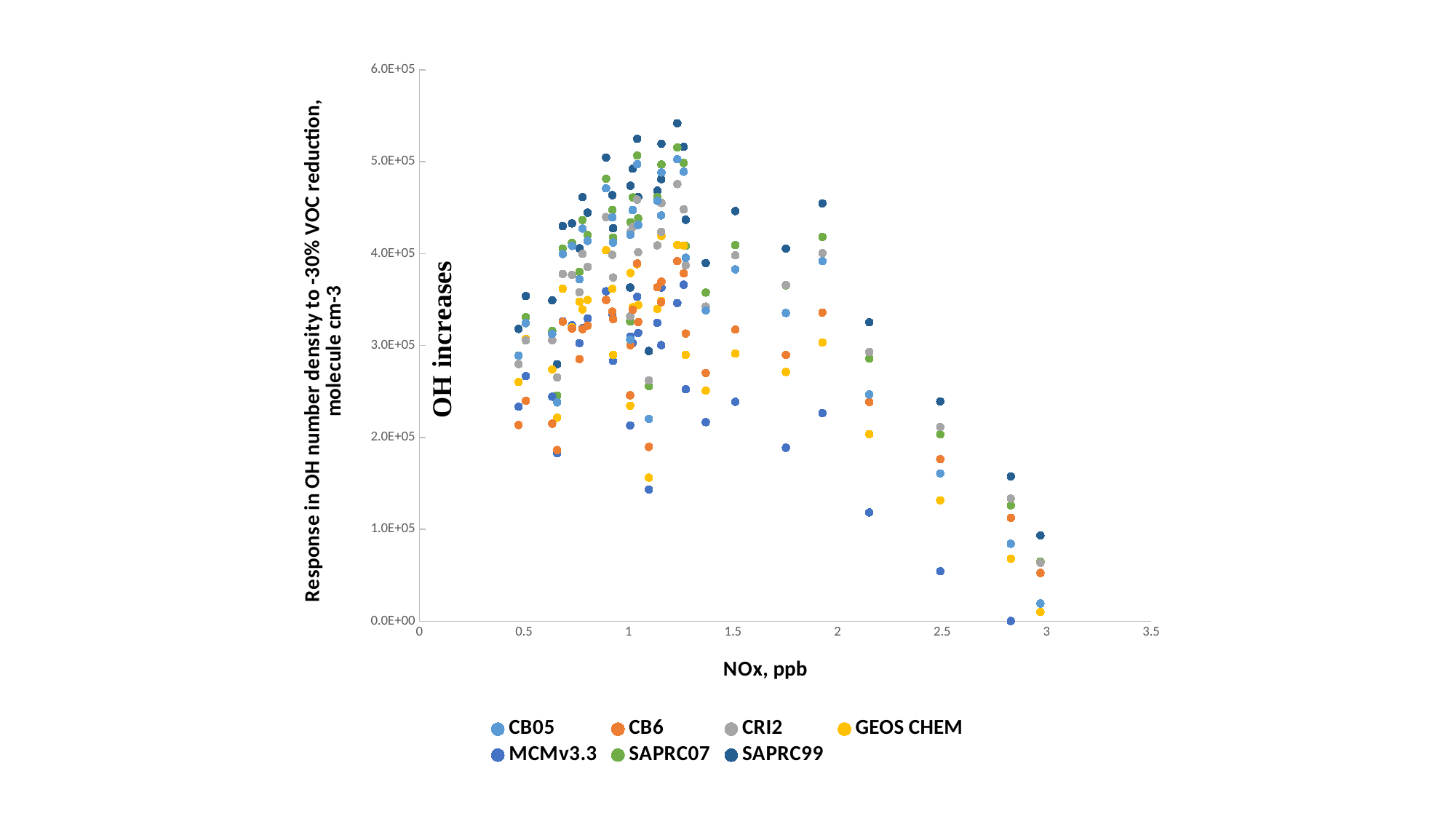
What kind of chart is shown on the slide? Scatter chart Which series has the lowest value near NOx 2.85 ppb? MCMv3.3 What is the title of the x axis? NOx, ppb Is the MCMv3.3 point near NOx 2.5 ppb greater or less than 1.0E+05? less How many series does the legend list? 7 Which series has the highest value near NOx 3 ppb? SAPRC99 Near NOx 2.5 ppb, which series has the larger value, SAPRC99 or MCMv3.3? SAPRC99 Is the GEOS CHEM point near NOx 3 ppb greater or less than 1.0E+05? less Is the SAPRC99 point near NOx 2.5 ppb greater or less than 2.0E+05? greater Which series is shown in orange in the legend? CB6 Do the values generally rise or fall as NOx increases from 1.5 ppb to 3 ppb? Fall